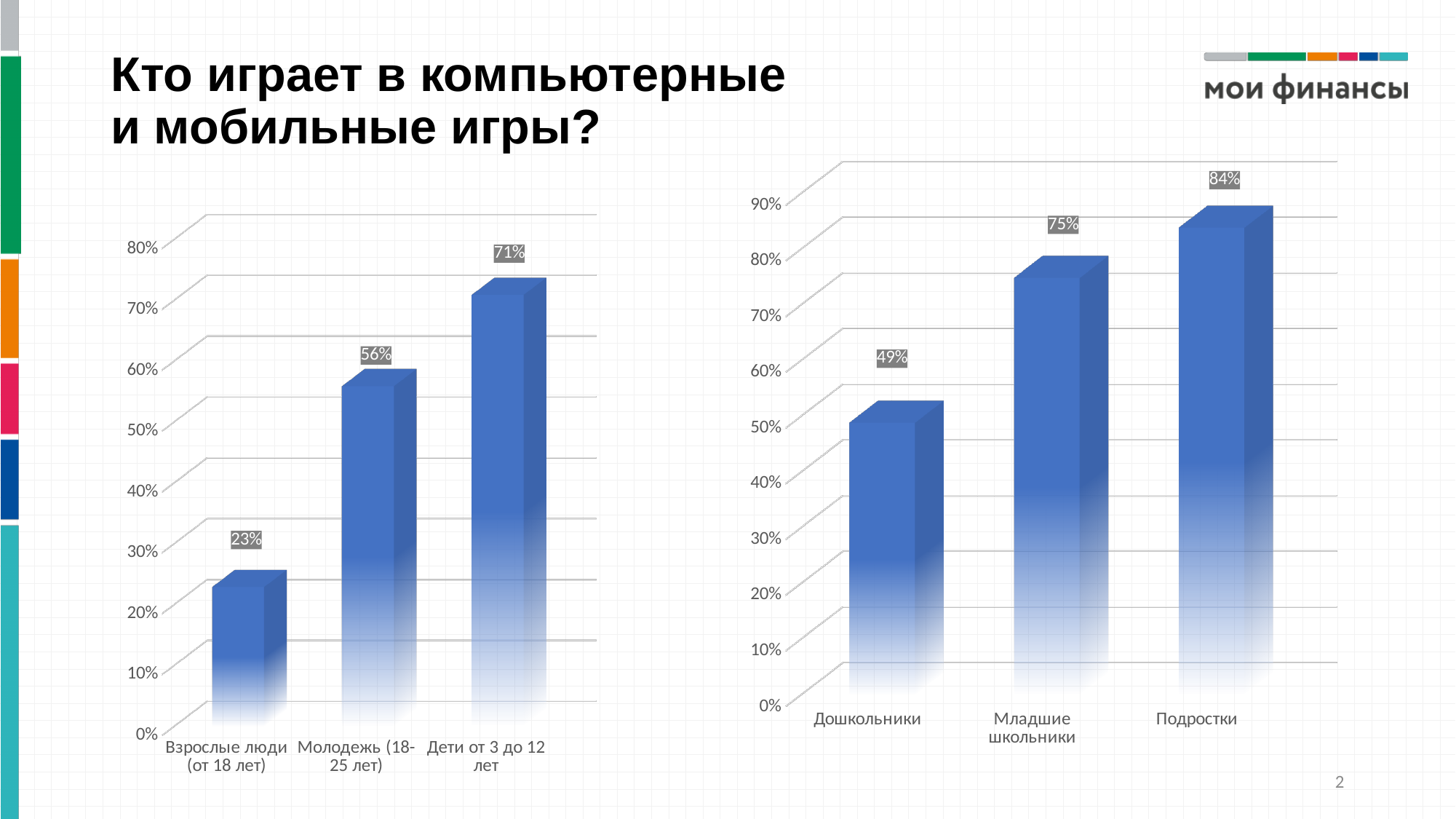
In the right chart, what is the difference between the values for Подростки and Дошкольники? 35% In the left chart, which category has the lowest value? Взрослые люди (от 18 лет) In the right chart, which is larger: the value for Дошкольники or the value for Младшие школьники? Младшие школьники In the left chart, what is the difference between the values for Дети от 3 до 12 лет and Взрослые люди (от 18 лет)? 48% In the right chart, what is the value for Младшие школьники? 75% In the left chart, is the value for Молодежь (18-25 лет) greater or less than 50%? greater In the left chart, what is the value for Взрослые люди (от 18 лет)? 23% In the right chart, which category has the highest value? Подростки In the left chart, what is the value for Молодежь (18-25 лет)? 56% How many categories are shown in the right chart? 3 What kind of chart is the left chart? bar chart In the right chart, do the values rise or fall from left to right along the x axis? rise